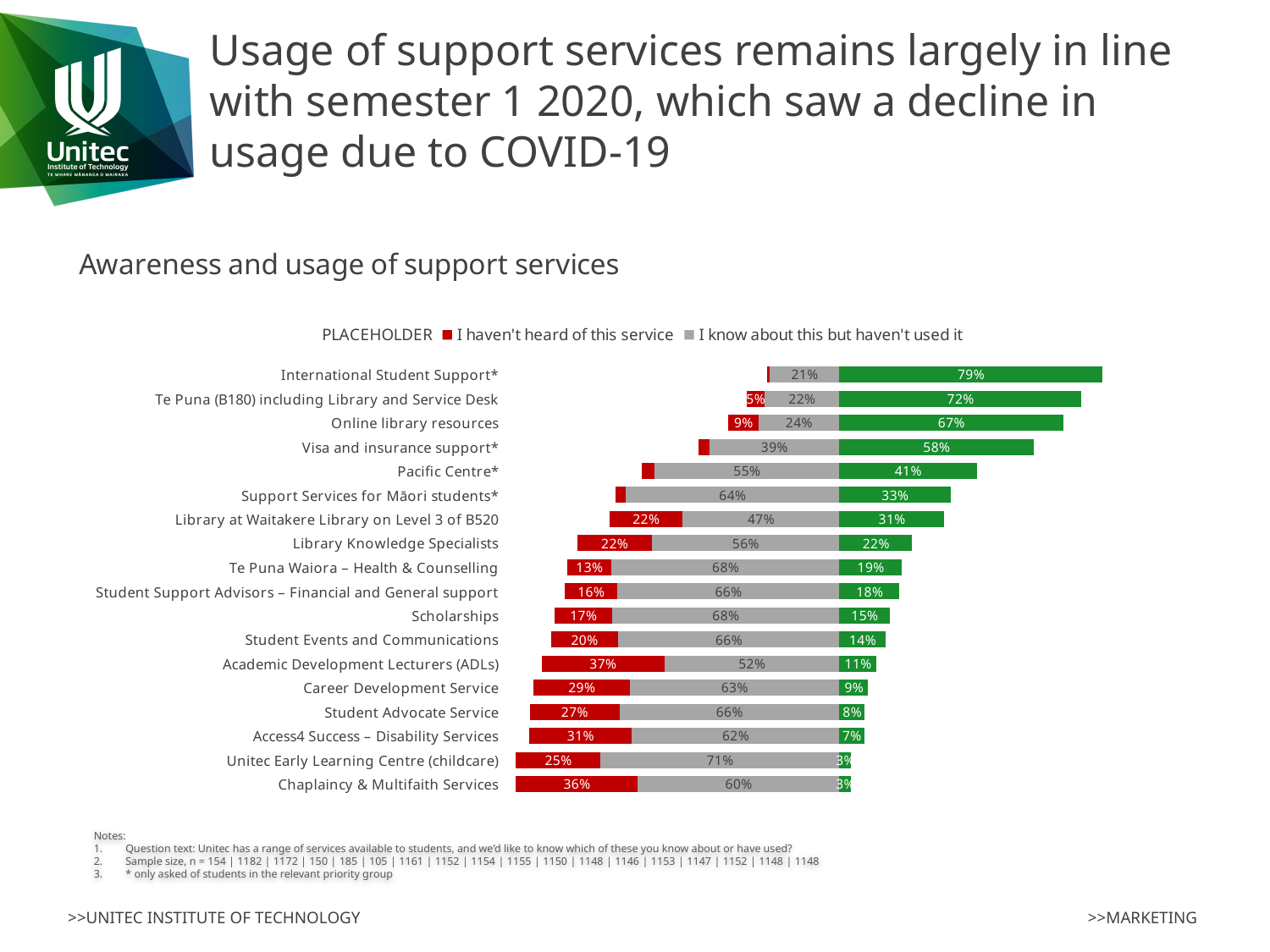
What colour represents 'I haven't heard of this service' in the chart? Red What is the green-bar value for International Student Support*? 79% What is the 'I haven't heard of this service' value for Academic Development Lecturers (ADLs)? 37% How many series does the legend list? 3 Which service has the lowest 'I know about this but haven't used it' value? International Student Support* What type of chart is shown on the slide? Stacked bar chart How many support services are listed in the chart? 18 What is the 'I know about this but haven't used it' value for Unitec Early Learning Centre (childcare)? 71% How many percentage points higher is the green-bar value for Te Puna (B180) including Library and Service Desk than for Online library resources? 5 percentage points Which service has the highest green-bar value? International Student Support* What percentage of respondents said 'I know about this but haven't used it' for Visa and insurance support*? 39% Which has a larger 'I haven't heard of this service' value: Chaplaincy & Multifaith Services or Career Development Service? Chaplaincy & Multifaith Services